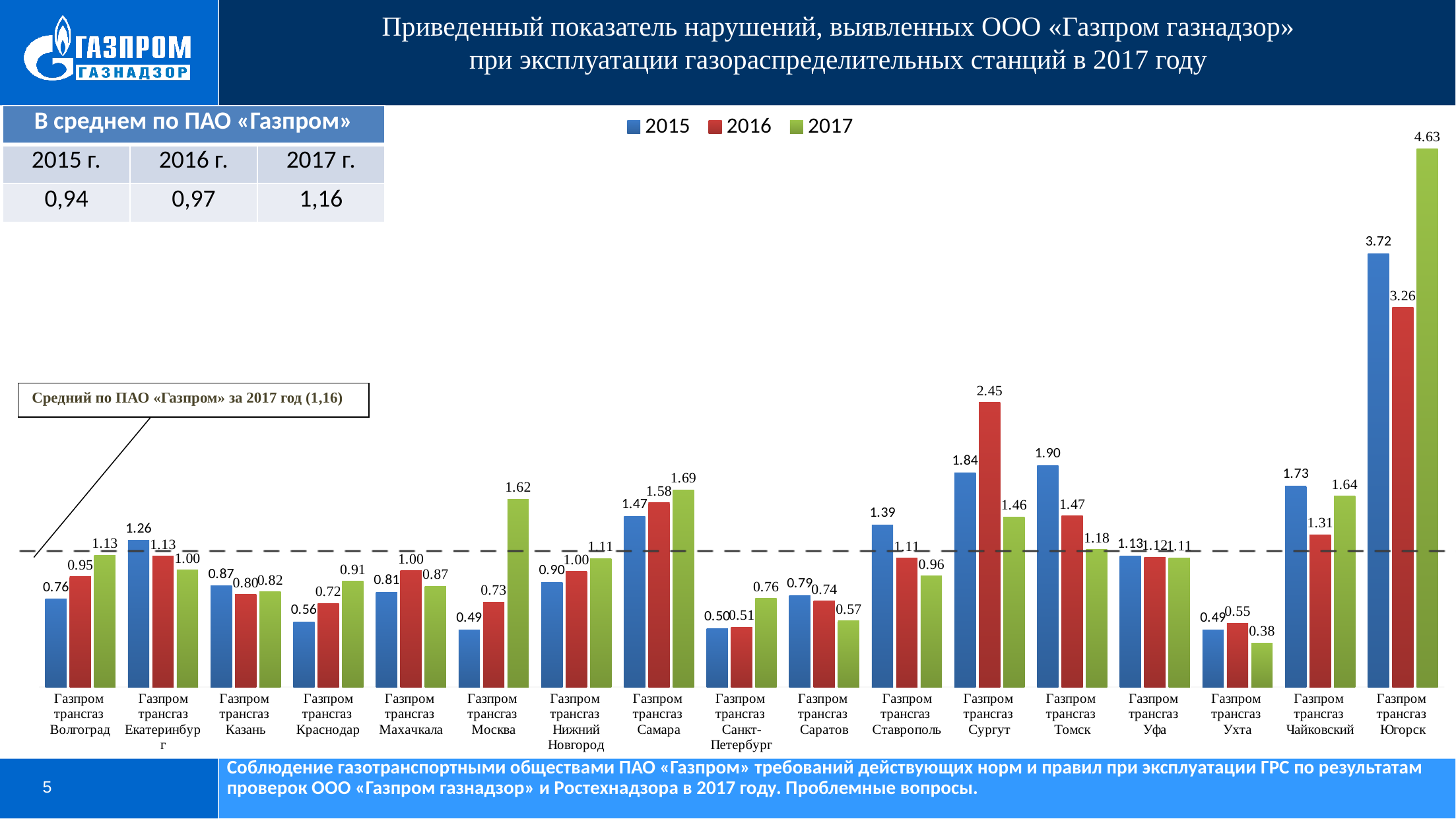
What value does the dashed horizontal line on the chart represent? 1,16 Which is larger for Газпром трансгаз Томск: the 2015 value or the 2016 value? 2015 What kind of chart is shown on the slide? Bar chart Which company has the lowest 2017 value? Газпром трансгаз Ухта What is the difference between the 2017 and 2015 values for Газпром трансгаз Москва? 1.13 What is the 2015 value for Газпром трансгаз Москва? 0.49 How many companies are shown on the x axis? 17 Which company has the highest 2017 value? Газпром трансгаз Югорск What is the 2017 value for Газпром трансгаз Югорск? 4.63 What is the 2016 value for Газпром трансгаз Сургут? 2.45 Do the values for Газпром трансгаз Самара rise or fall from 2015 to 2017? Rise How many series does the legend list? 3